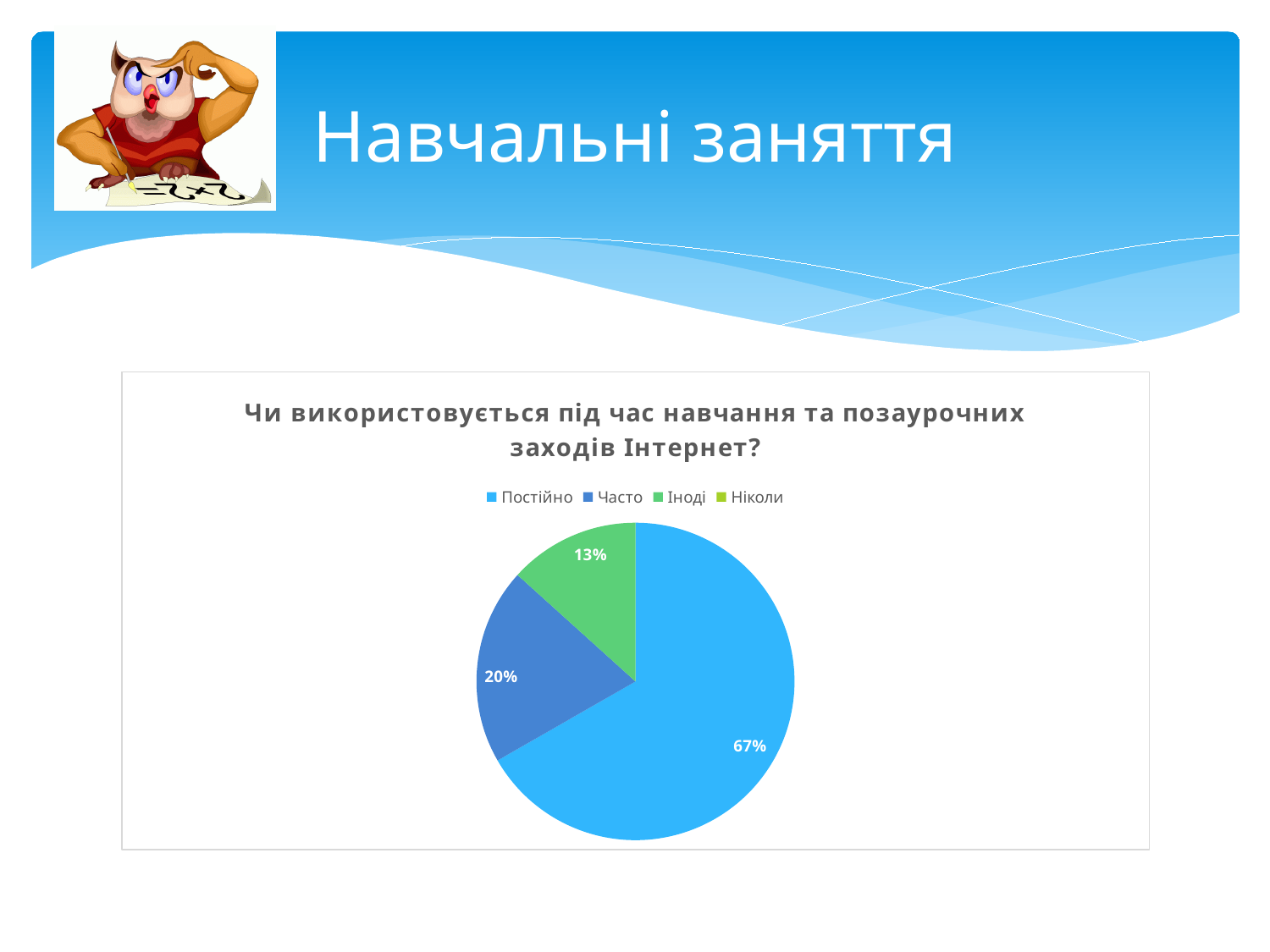
What share of the pie does Часто have? 20% Which category has the largest slice of the pie? Постійно What share of the pie does Постійно have? 67% What kind of chart is shown on the slide? pie chart What is the title of the chart? Чи використовується під час навчання та позаурочних заходів Інтернет? What is the difference between the shares for Часто and Іноді? 7% Which labelled slice of the pie is the smallest? Іноді Which is larger, the share for Часто or the share for Іноді? Часто What is the difference between the shares for Постійно and Часто? 47% How many entries does the legend list? 4 What share of the pie does Іноді have? 13% How many slices with percentage labels are shown in the pie? 3